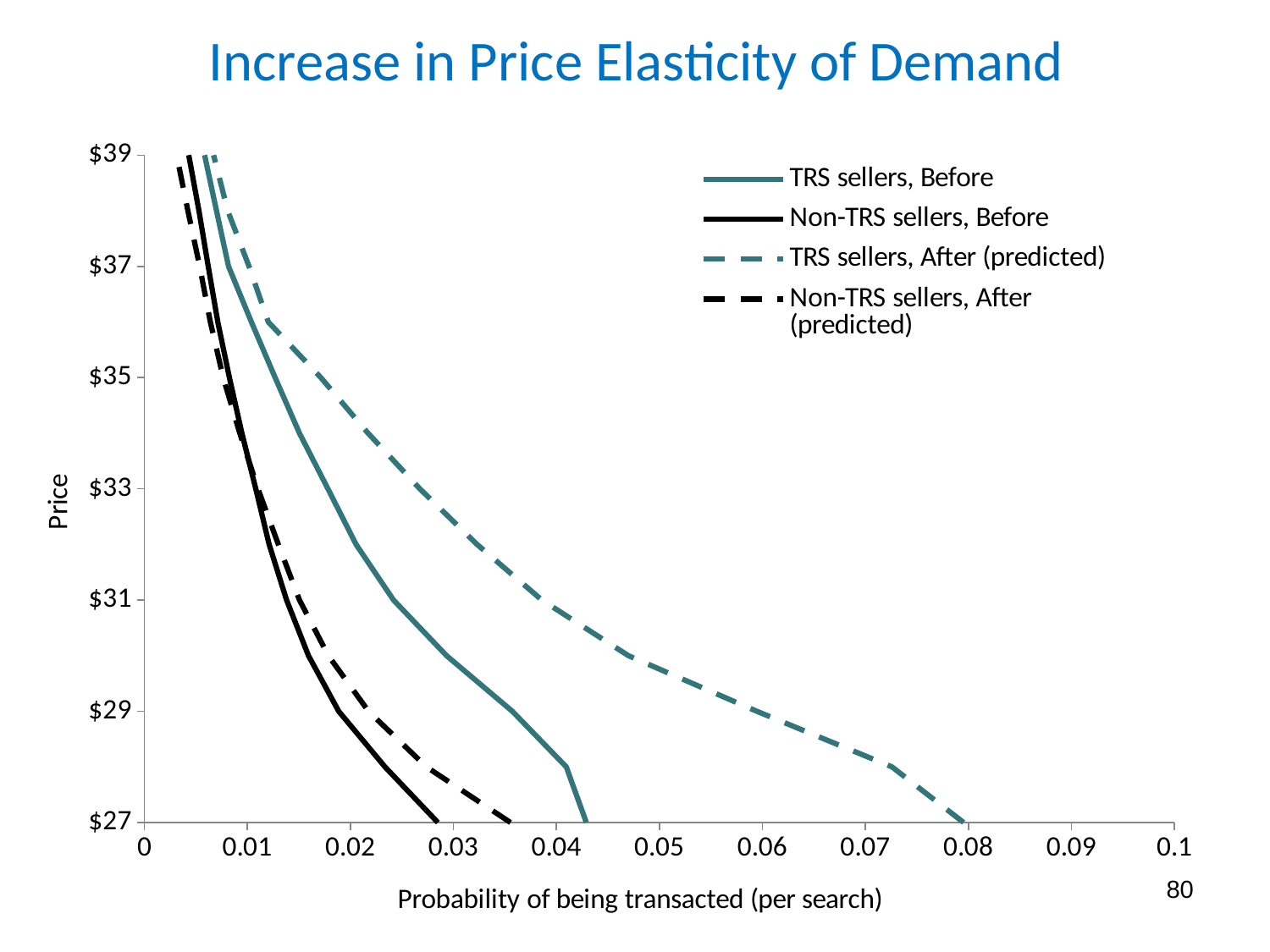
Is the probability of being transacted for Non-TRS sellers, After (predicted) at $27 greater or less than 0.03? greater Which series has the lowest probability of being transacted at a price of $27? Non-TRS sellers, Before Is the probability of being transacted for TRS sellers, After (predicted) at $31 greater or less than 0.04? greater What is the label of the horizontal axis? Probability of being transacted (per search) At a price of $31, which has the larger probability of being transacted: TRS sellers, Before or Non-TRS sellers, Before? TRS sellers, Before How many series does the legend list? 4 What is the title of the chart? Increase in Price Elasticity of Demand Which series reaches the highest probability of being transacted at a price of $27? TRS sellers, After (predicted) Is the probability of being transacted for Non-TRS sellers, Before at $27 greater or less than 0.03? less What kind of chart is shown on the slide? line chart As the price increases from $27 to $39, does the probability of being transacted for TRS sellers, After (predicted) rise or fall? fall